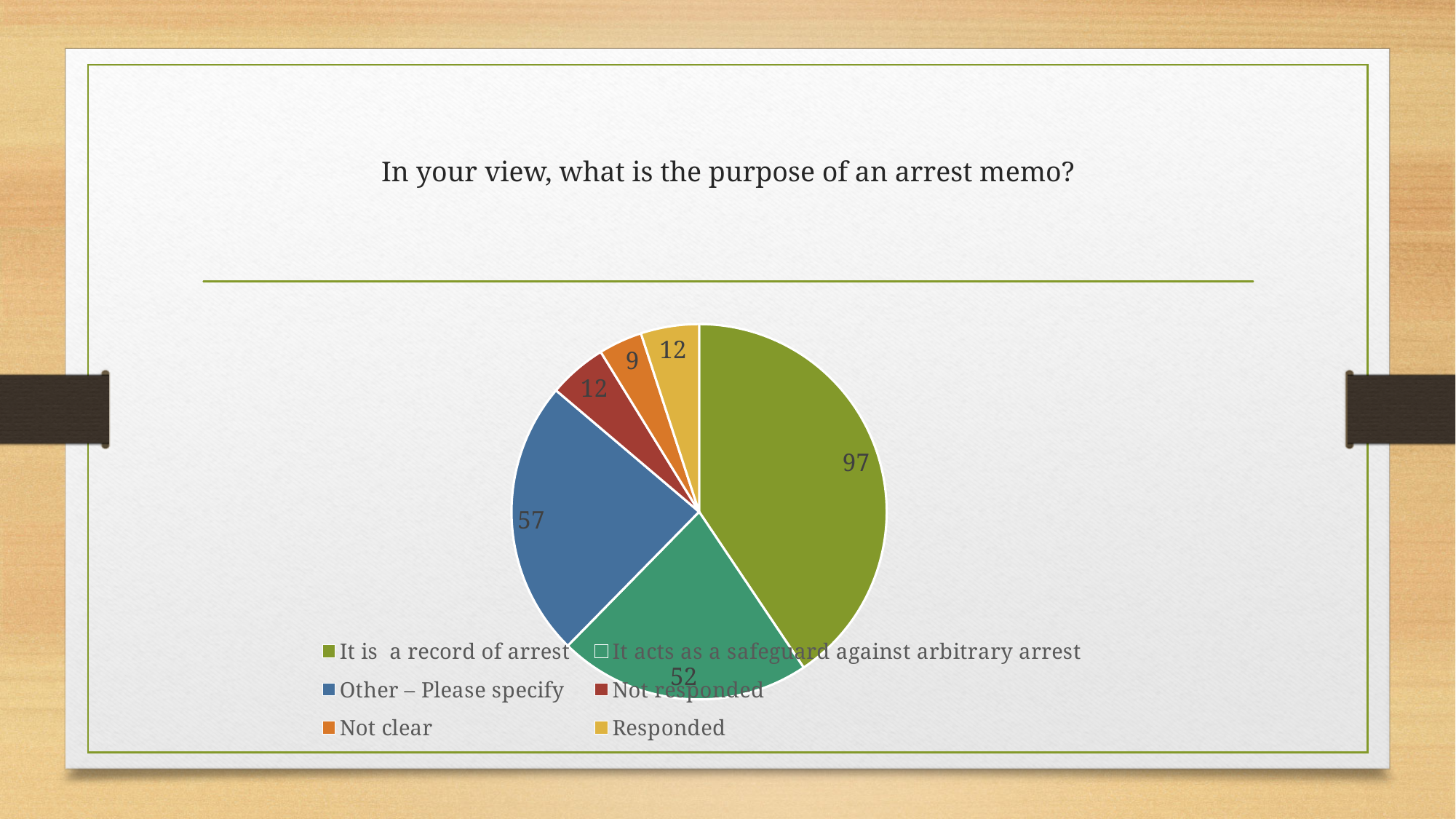
How many categories does the pie chart have? 6 What type of chart is shown on the slide? Pie chart What is the title of the chart? In your view, what is the purpose of an arrest memo? What is the value for "It is a record of arrest"? 97 What is the value for "Other – Please specify"? 57 Which is larger, the value for "Other – Please specify" or the value for "It acts as a safeguard against arbitrary arrest"? Other – Please specify What is the total of all the values shown in the pie chart? 239 Which category has the largest slice of the pie? It is a record of arrest What is the difference between the values for "It is a record of arrest" and "Other – Please specify"? 40 Which category has the smallest slice of the pie? Not clear What is the value for "Not clear"? 9 What is the value for "It acts as a safeguard against arbitrary arrest"? 52